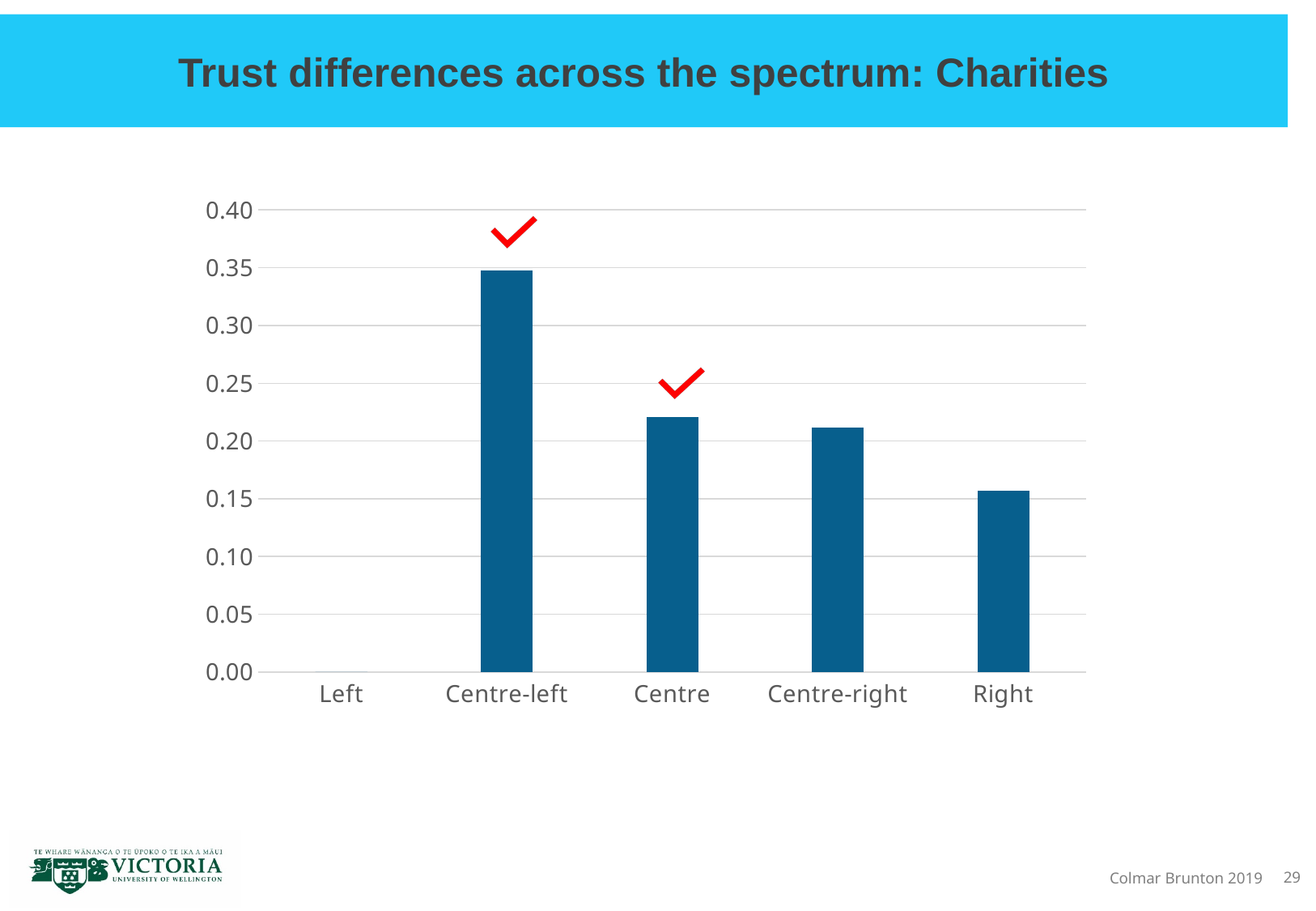
Is the value for Right greater or less than 0.20? less Is the value for Left greater or less than 0.05? less Which category has the highest value? Centre-left Which is larger, the value for Centre-left or the value for Right? Centre-left Do the values rise or fall moving from Centre-left to Right along the x axis? fall Is the value for Centre-right greater or less than 0.25? less What kind of chart is shown on the slide? Bar chart How many red check marks are drawn above the bars? 2 What is the title of the slide? Trust differences across the spectrum: Charities How many categories are shown on the x axis? 5